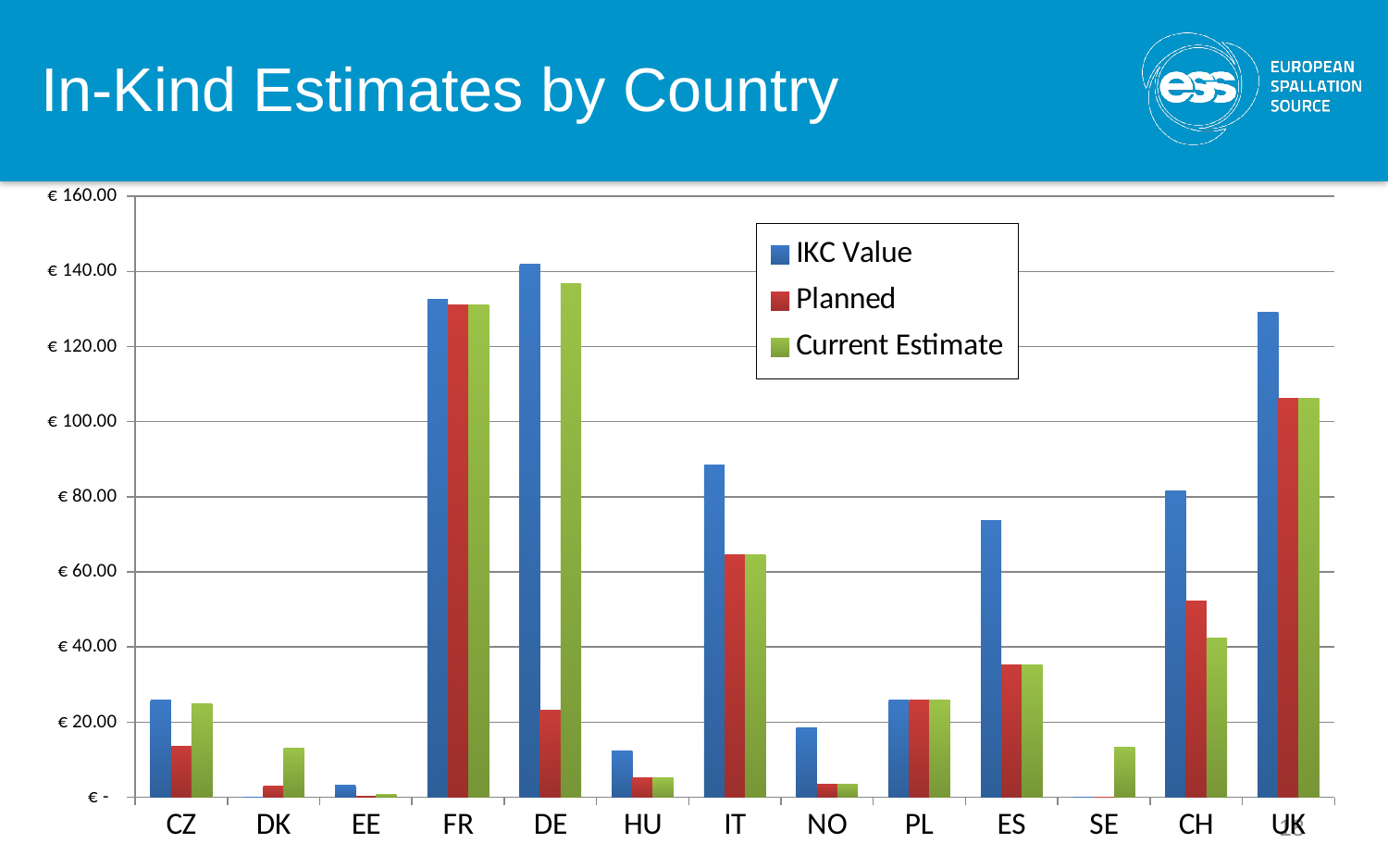
Is the Planned value for CH greater or less than 40? greater Is the Planned value for DE greater or less than 40? less What is the title of the slide containing the chart? In-Kind Estimates by Country For DE, which is larger: the Planned value or the Current Estimate? Current Estimate Is the IKC Value for FR greater or less than 120? greater How many countries are shown on the x axis of the chart? 13 For CH, which is larger: the Planned value or the Current Estimate? Planned Which country has the highest IKC Value? DE Which country has the highest Planned value? FR How many series does the chart legend list? 3 What kind of chart is shown on the slide? bar chart